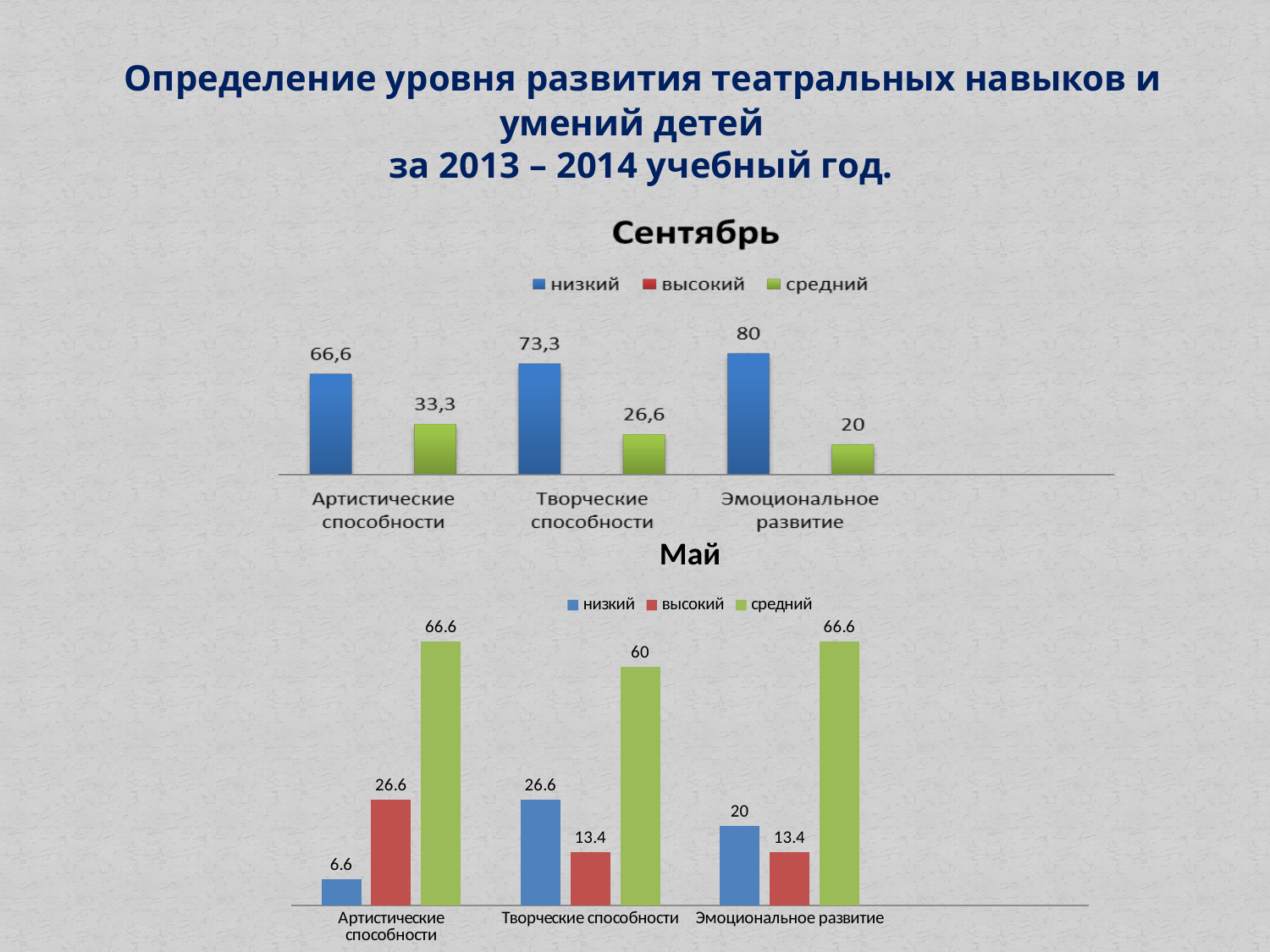
In the "Сентябрь" chart, what is the value of средний for Артистические способности? 33,3 In the "Май" chart, is низкий or высокий larger for Творческие способности? низкий In the "Сентябрь" chart, what is the difference between низкий and средний for Творческие способности? 46,7 In the "Май" chart, what is the value of средний for Творческие способности? 60 In the "Сентябрь" chart, which category has the highest низкий value? Эмоциональное развитие In the "Май" chart, what is the difference between средний and низкий for Эмоциональное развитие? 46.6 What kind of chart is the "Сентябрь" chart? Bar chart In the "Май" chart, which category has the lowest низкий value? Артистические способности In the "Май" chart, what is the value of высокий for Артистические способности? 26.6 In the "Сентябрь" chart, which category has the lowest средний value? Эмоциональное развитие In the "Сентябрь" chart, what is the value of низкий for Эмоциональное развитие? 80 How many series does the legend of the "Май" chart list? 3